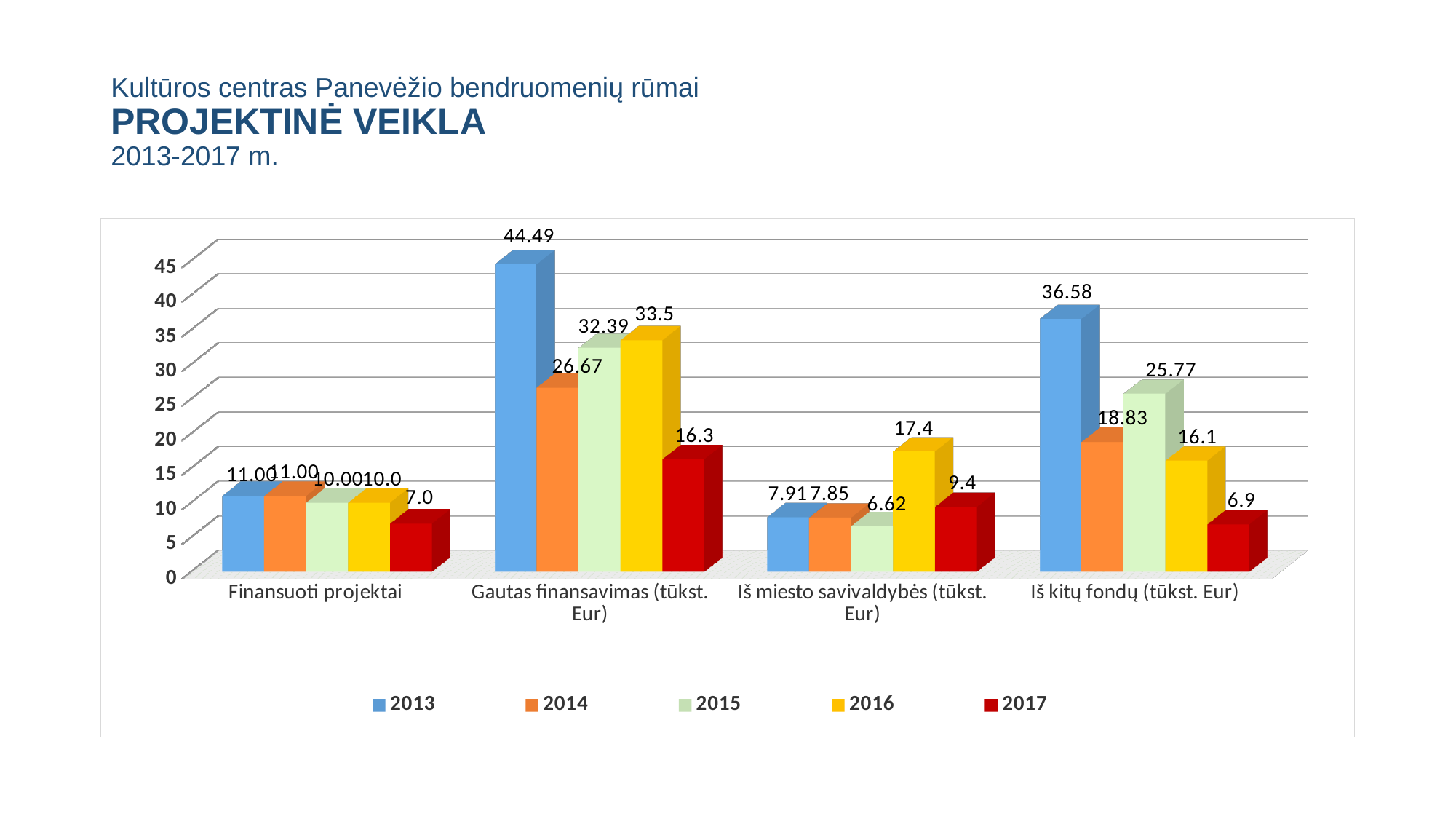
What is the value for 2015 in the 'Iš kitų fondų (tūkst. Eur)' category? 25.77 What kind of chart is shown on the slide? Bar chart What is the value for 2016 in the 'Iš miesto savivaldybės (tūkst. Eur)' category? 17.4 Which year has the highest value in the 'Iš kitų fondų (tūkst. Eur)' category? 2013 What is the value for 2013 in the 'Gautas finansavimas (tūkst. Eur)' category? 44.49 What is the difference between the 2013 and 2017 values in the 'Gautas finansavimas (tūkst. Eur)' category? 28.19 Which year has the lowest value in the 'Gautas finansavimas (tūkst. Eur)' category? 2017 How many categories are shown on the x axis? 4 What is the value for 2017 in the 'Finansuoti projektai' category? 7.0 Is the value for 2016 in the 'Gautas finansavimas (tūkst. Eur)' category greater or less than 30? greater How many series does the legend list? 5 In the 'Iš kitų fondų (tūkst. Eur)' category, which is larger: the value for 2014 or the value for 2016? 2014